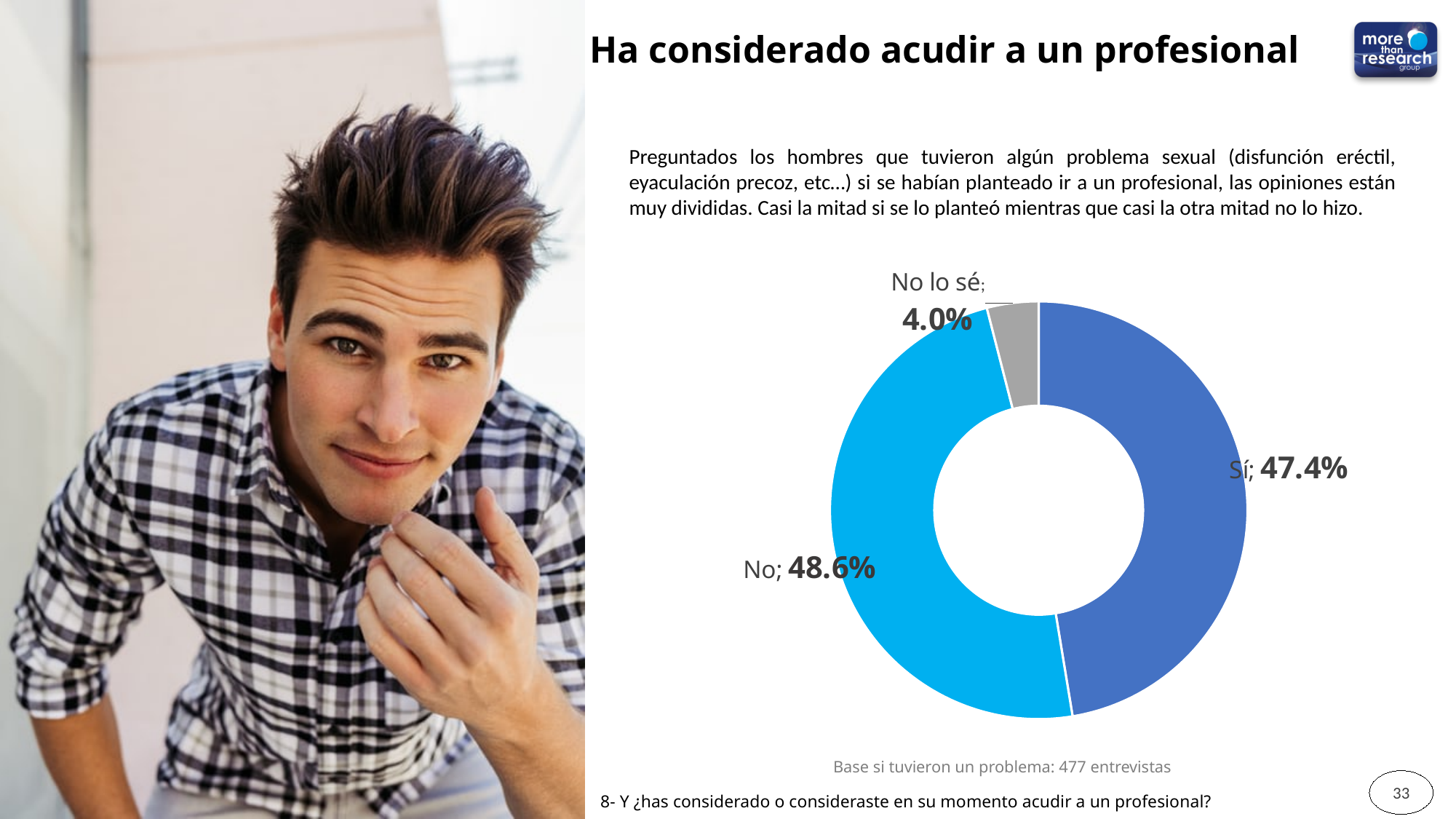
How many categories are shown in the chart? 3 Which category has the largest share of the chart? No What kind of chart is shown on the slide? Doughnut (pie) chart What percentage of respondents answered "Sí"? 47.4% What percentage of respondents answered "No lo sé"? 4.0% Which category has the smallest share of the chart? No lo sé What is the difference in percentage points between "Sí" and "No lo sé"? 43.4 What colour is the "No lo sé" slice? Grey What is the title of the slide containing the chart? Ha considerado acudir a un profesional What is the difference in percentage points between "No" and "Sí"? 1.2 Which is larger, the share for "Sí" or the share for "No lo sé"? Sí What percentage of respondents answered "No"? 48.6%